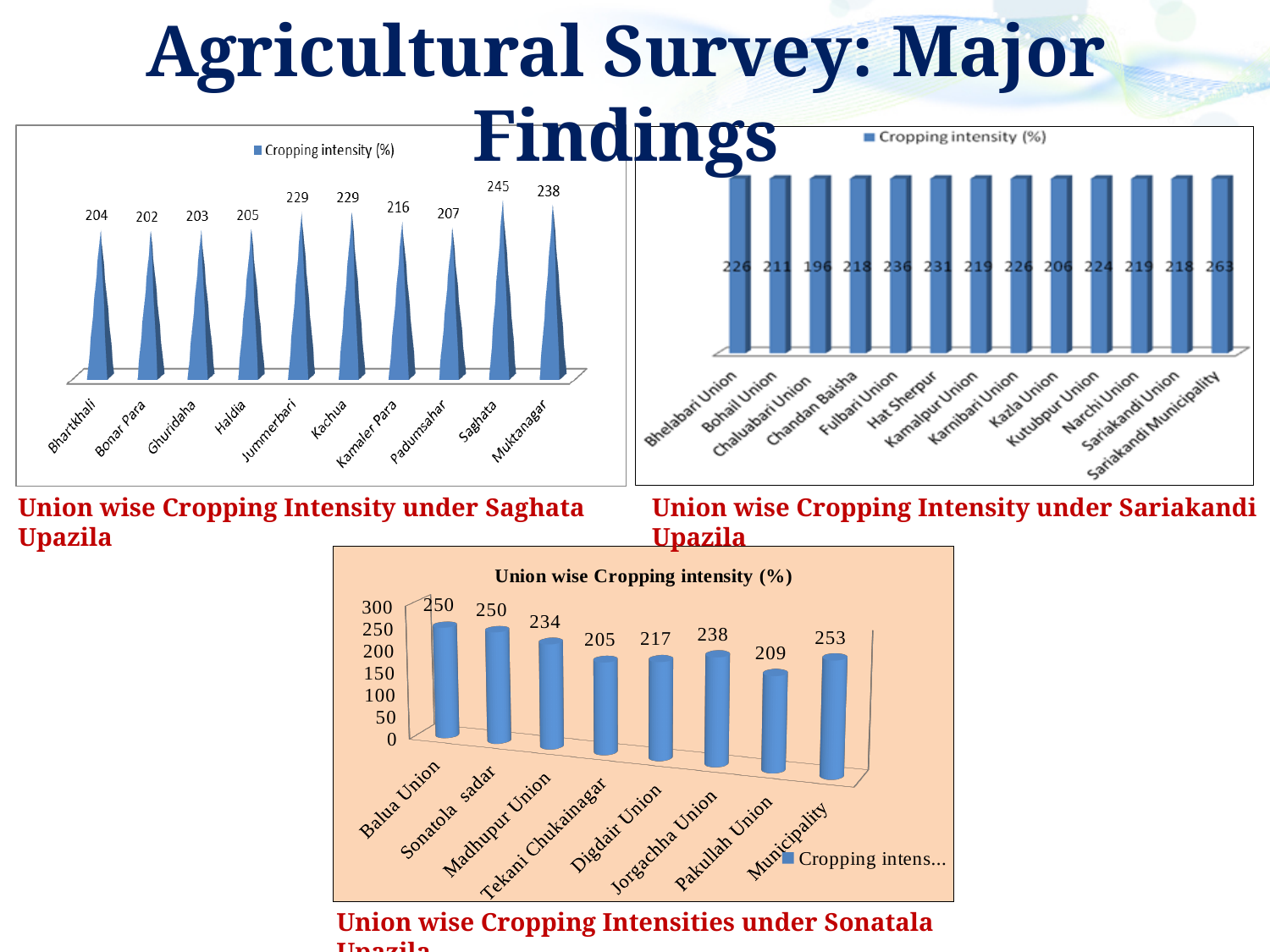
In the chart for Sariakandi Upazila (top right), what is the cropping intensity for Fulbari Union? 236 In the chart for Saghata Upazila (top left), what is the cropping intensity for Saghata? 245 In the chart for Sonatala Upazila (bottom), which category has the highest cropping intensity? Municipality In the chart for Saghata Upazila (top left), how many unions are plotted? 10 In the chart for Saghata Upazila (top left), what is the difference between the values for Muktanagar and Bhartkhali? 34 In the chart for Sariakandi Upazila (top right), how many categories are shown? 13 In the chart for Sonatala Upazila (bottom), which is larger, the value for Madhupur Union or Pakullah Union? Madhupur Union In the chart for Saghata Upazila (top left), which union has the lowest cropping intensity? Bonar Para In the chart for Sonatala Upazila (bottom), what is the cropping intensity for Jorgachha Union? 238 In the chart for Sariakandi Upazila (top right), which category has the lowest cropping intensity? Chaluabari Union In the chart for Sariakandi Upazila (top right), which category has the highest cropping intensity? Sariakandi Municipality What type of chart is the bottom chart titled 'Union wise Cropping intensity (%)'? Bar chart